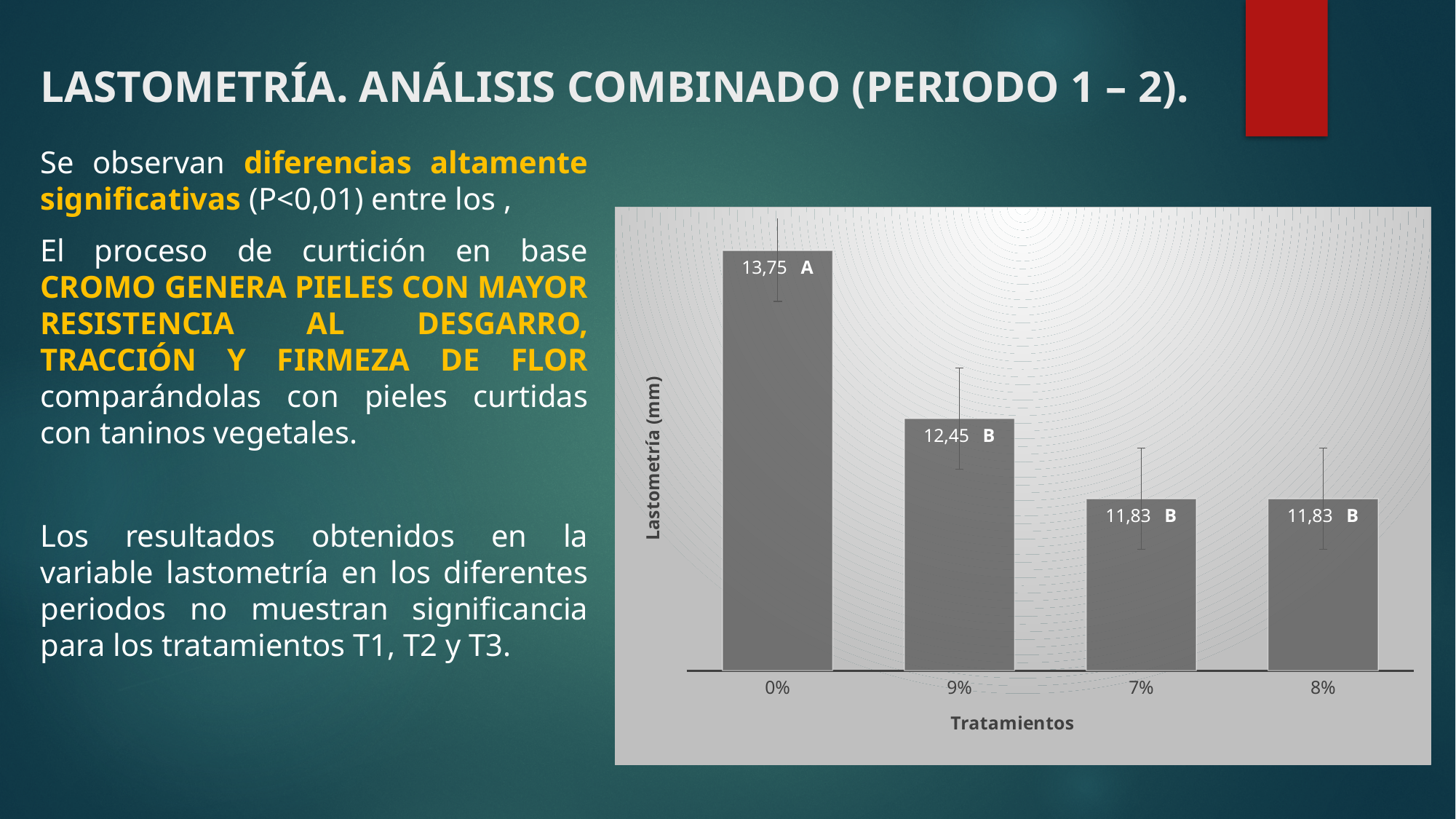
What is the lastometría value for the 7% treatment? 11,83 What is the difference between the lastometría values for the 0% and 9% treatments? 1,30 What kind of chart is shown on the slide? Bar chart Which has a larger lastometría value, the 0% treatment or the 9% treatment? 0% What is the lastometría value for the 9% treatment? 12,45 What is the difference between the lastometría values for the 9% and 7% treatments? 0,62 What is the title of the vertical axis of the chart? Lastometría (mm) How many treatment categories are shown on the x axis? 4 What is the lastometría value for the 0% treatment? 13,75 Do the lastometría values rise or fall from the 0% treatment to the 7% treatment along the x axis? Fall What is the lastometría value for the 8% treatment? 11,83 Which treatment has the highest lastometría value? 0%